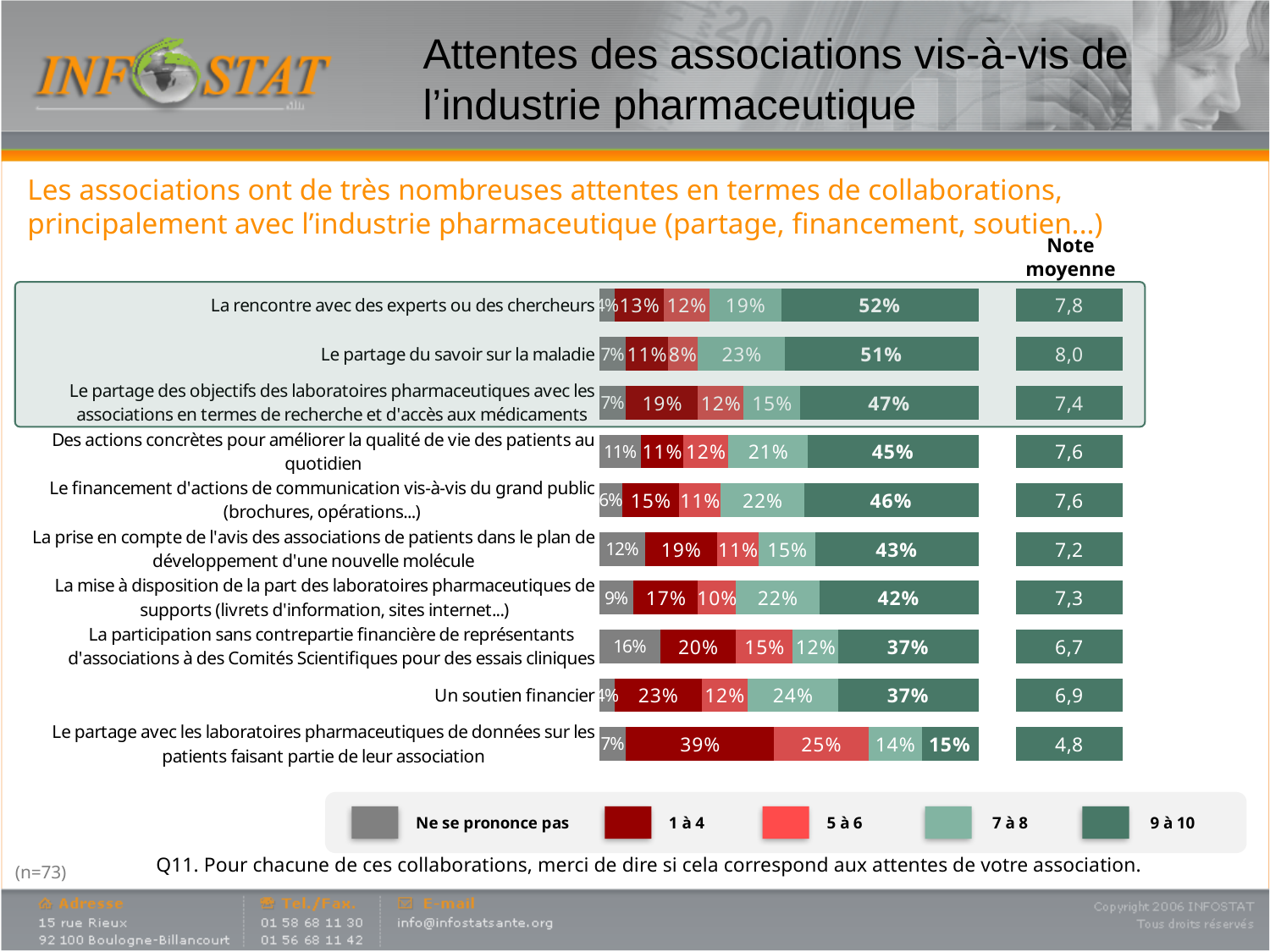
What is the total of the stacked bar for "La rencontre avec des experts ou des chercheurs"? 100% Which collaboration has the highest share of 9 à 10 scores? La rencontre avec des experts ou des chercheurs Which has a larger 1 à 4 share: "Un soutien financier" or "La mise à disposition de la part des laboratoires pharmaceutiques de supports"? Un soutien financier What percentage of associations gave a score of 9 à 10 for "Un soutien financier"? 37% What is the difference in percentage points between the 9 à 10 share for "La rencontre avec des experts ou des chercheurs" and for "Le partage du savoir sur la maladie"? 1 percentage point What kind of chart is shown on the slide? Stacked bar chart Which collaboration has the highest share of 1 à 4 scores? Le partage avec les laboratoires pharmaceutiques de données sur les patients faisant partie de leur association Which collaboration has the lowest share of 9 à 10 scores? Le partage avec les laboratoires pharmaceutiques de données sur les patients faisant partie de leur association How many collaborations (categories) are shown on the chart? 10 What is the "Note moyenne" for "Le partage du savoir sur la maladie"? 8,0 How many series does the legend list? 5 What is the lowest "Note moyenne" shown on the chart? 4,8